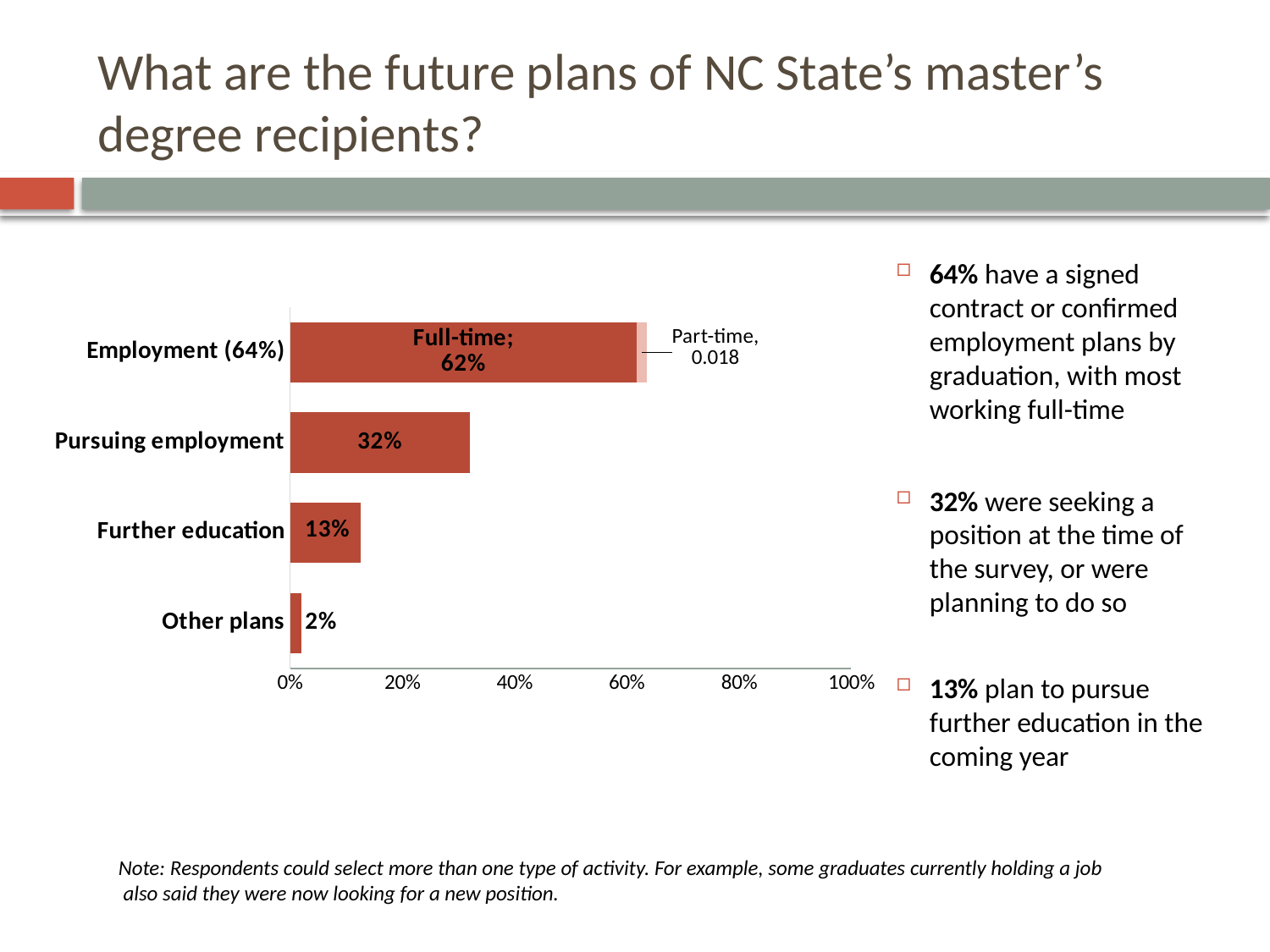
What is the Full-time value shown in the Employment bar? 62% What is the value for Other plans? 2% What is the value for Further education? 13% How many categories are shown on the chart? 4 Which is larger, the value for Further education or the value for Other plans? Further education Which category has the highest total value? Employment (64%) What is the value for Pursuing employment? 32% What is the Part-time value shown for the Employment bar? 0.018 Which category has the lowest value? Other plans What is the difference between the Pursuing employment value and the Further education value? 19% Is the value for Pursuing employment greater or less than 40%? less What kind of chart is shown on the slide? bar chart